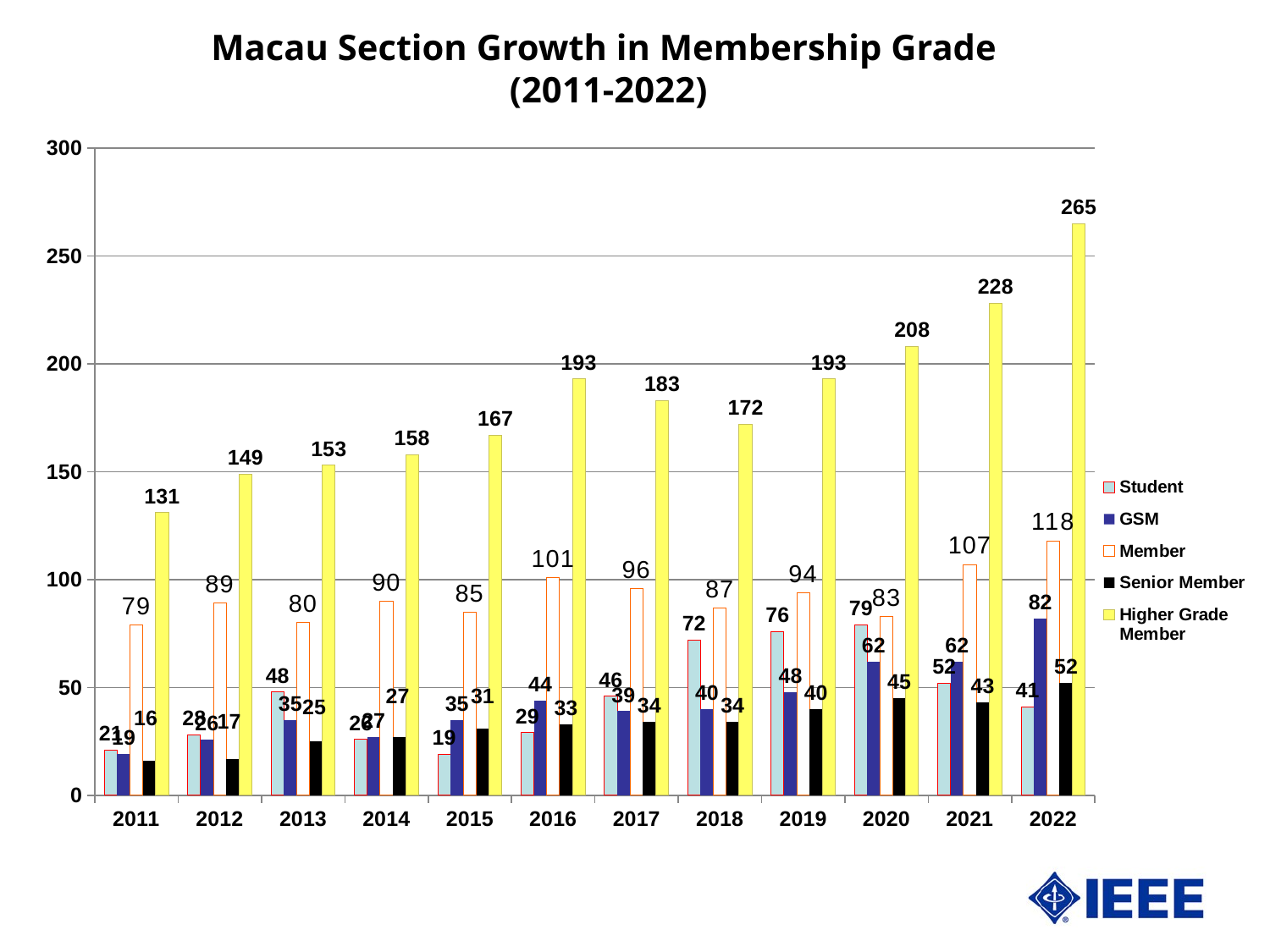
What is the value for Student in 2019? 76 What is the difference between the Higher Grade Member values for 2022 and 2021? 37 What is the value for Senior Member in 2022? 52 Does the Higher Grade Member value rise or fall from 2019 to 2022? Rise In which year is the Higher Grade Member value lowest? 2011 How many years are shown on the x axis? 12 How many series does the legend list? 5 What kind of chart is shown on the slide? Bar chart In 2022, which is larger: the Student value or the GSM value? GSM What is the value for Higher Grade Member in 2022? 265 What is the value for Member in 2021? 107 In which year is the Higher Grade Member value highest? 2022